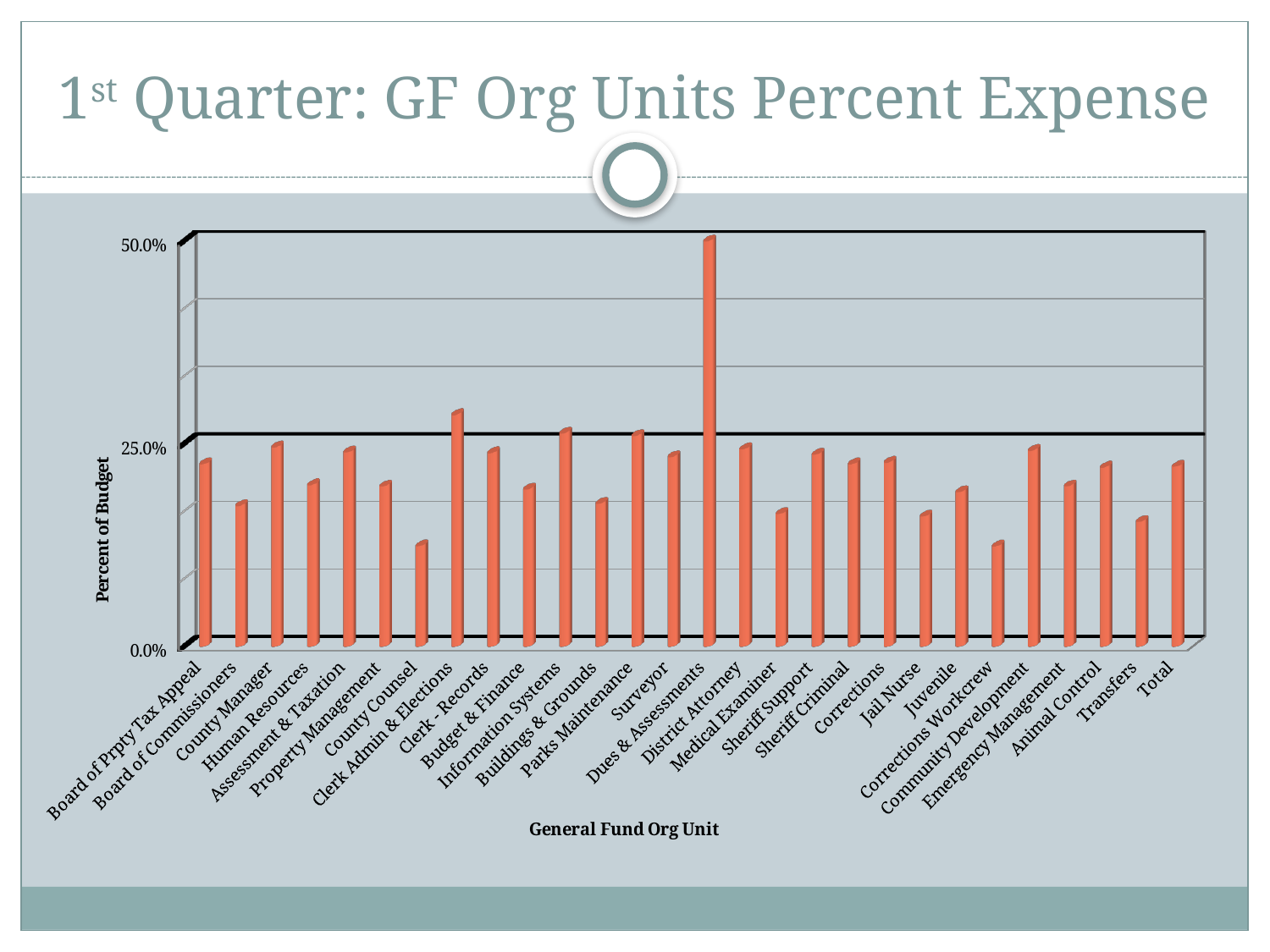
Is the value for County Counsel greater or less than 25.0%? less Which is larger, the value for Dues & Assessments or the value for Total? Dues & Assessments What is the label of the vertical axis? Percent of Budget Which is larger, the value for Clerk Admin & Elections or the value for County Counsel? Clerk Admin & Elections What kind of chart is shown on the slide? Bar chart Which General Fund Org Unit has the highest percent of budget expensed? Dues & Assessments How many categories are plotted along the x axis? 28 Which is larger, the value for Information Systems or the value for Medical Examiner? Information Systems Is the value for Clerk Admin & Elections greater or less than 25.0%? greater Is the value for Corrections Workcrew greater or less than 25.0%? less What is the label of the horizontal axis? General Fund Org Unit